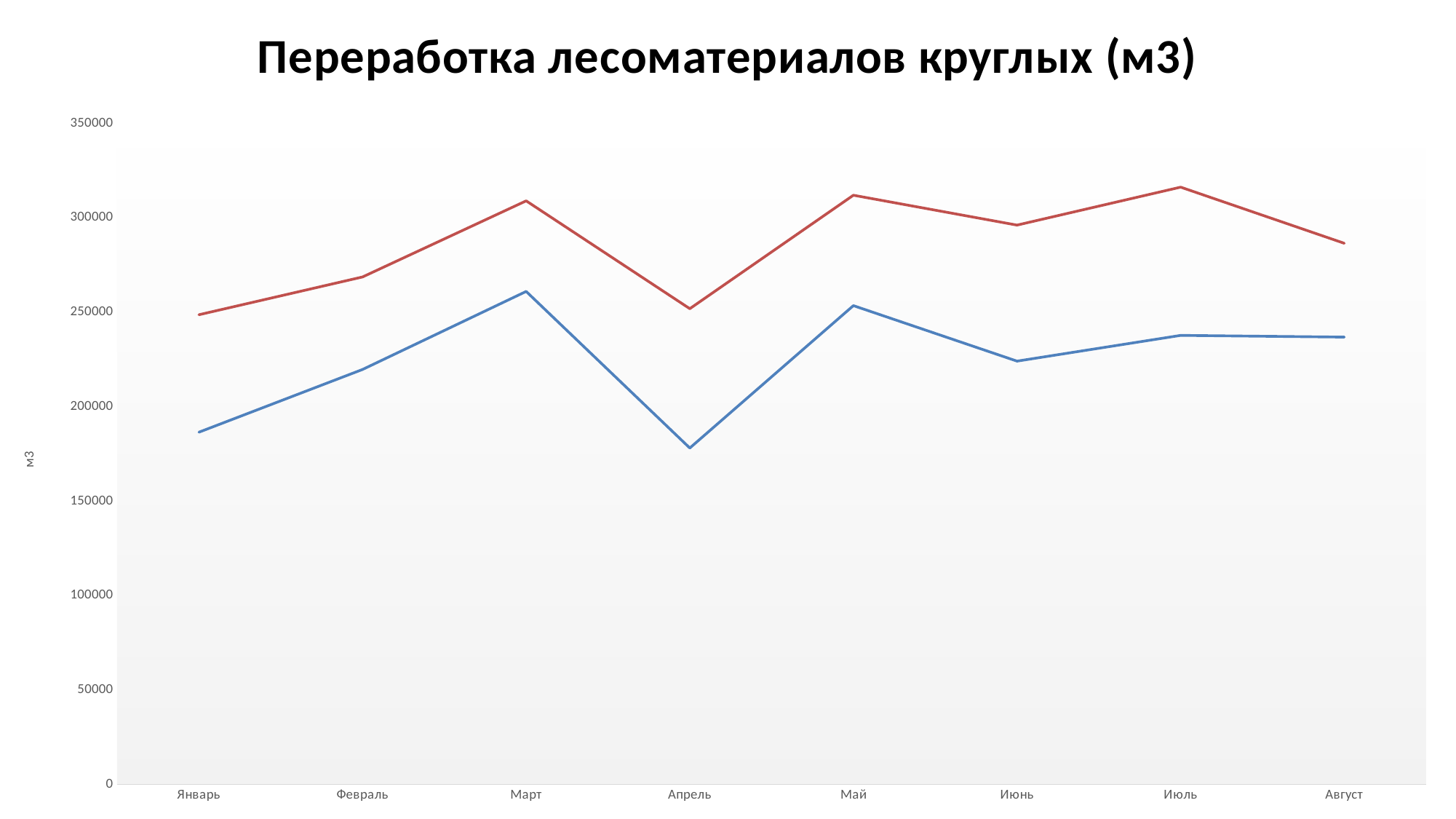
How many lines are plotted on the chart? 2 What is the title of the chart? Переработка лесоматериалов круглых (м3) In which month does the blue line reach its highest value? Март In which month does the blue line reach its lowest value? Апрель Does the blue line rise or fall from Январь to Март? rise Is the value of the red line for Август greater or less than 300000? less What label is shown on the vertical axis of the chart? м3 Is the value of the blue line for Апрель greater or less than 200000? less How many months are shown on the x axis of the chart? 8 Is the value of the red line for Март greater or less than 300000? greater What kind of chart is shown on the slide? line chart Which line has the higher value in Май, the red line or the blue line? the red line